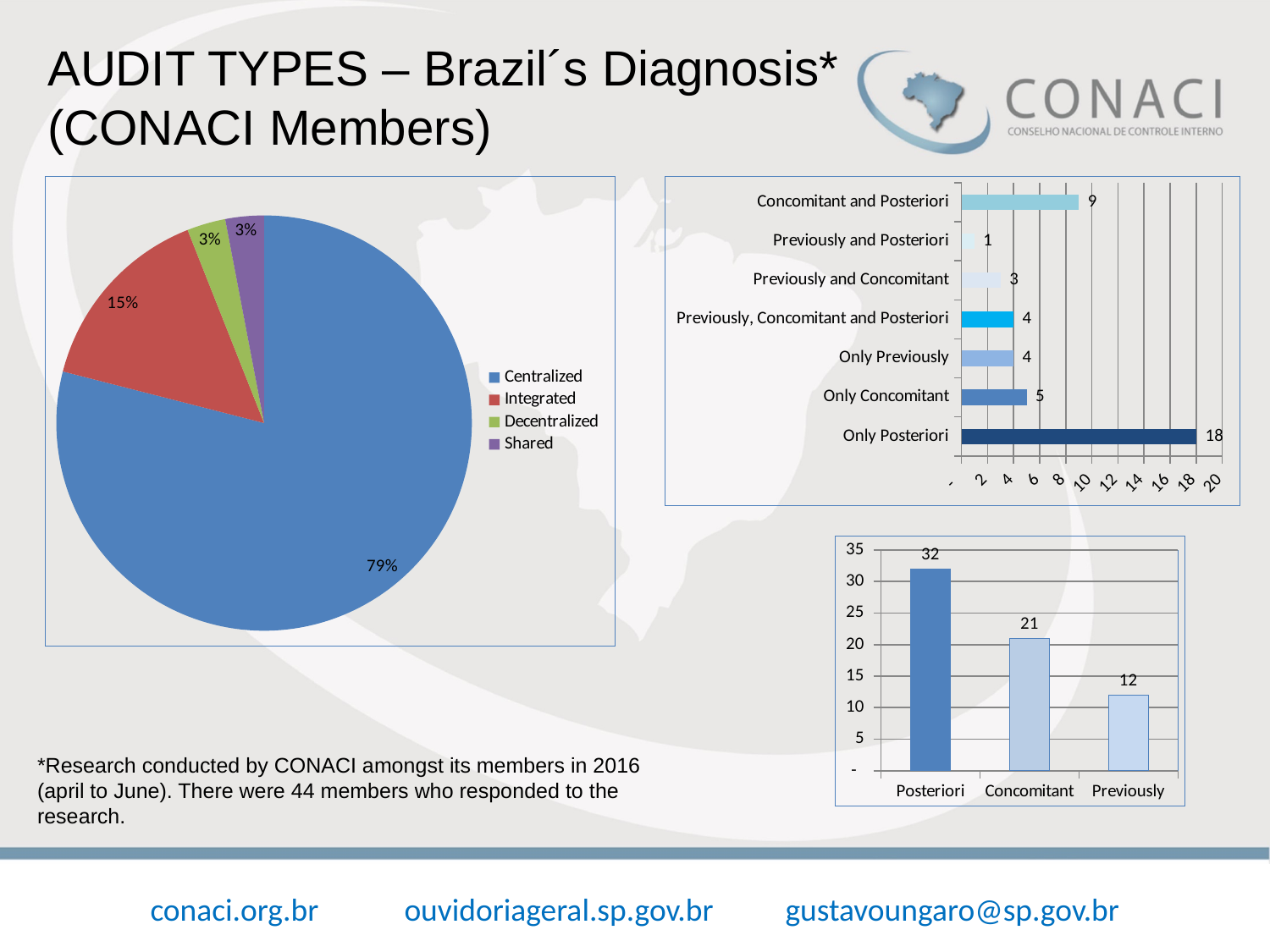
In the horizontal bar chart at the top right, what is the difference between Only Posteriori and Only Concomitant? 13 What kind of chart is shown at the bottom right of the slide? Bar chart In the horizontal bar chart at the top right, what is the value for Concomitant and Posteriori? 9 How many entries does the legend of the pie chart on the left list? 4 In the pie chart on the left, what share does Integrated have? 15% How many categories are shown in the horizontal bar chart at the top right? 7 In the horizontal bar chart at the top right, what is the value for Only Posteriori? 18 In the horizontal bar chart at the top right, which category has the lowest value? Previously and Posteriori In the pie chart on the left, which category has the largest slice? Centralized In the pie chart on the left, what share does Centralized have? 79% In the bar chart at the bottom right, what is the value for Concomitant? 21 In the bar chart at the bottom right, which is larger, Posteriori or Previously? Posteriori